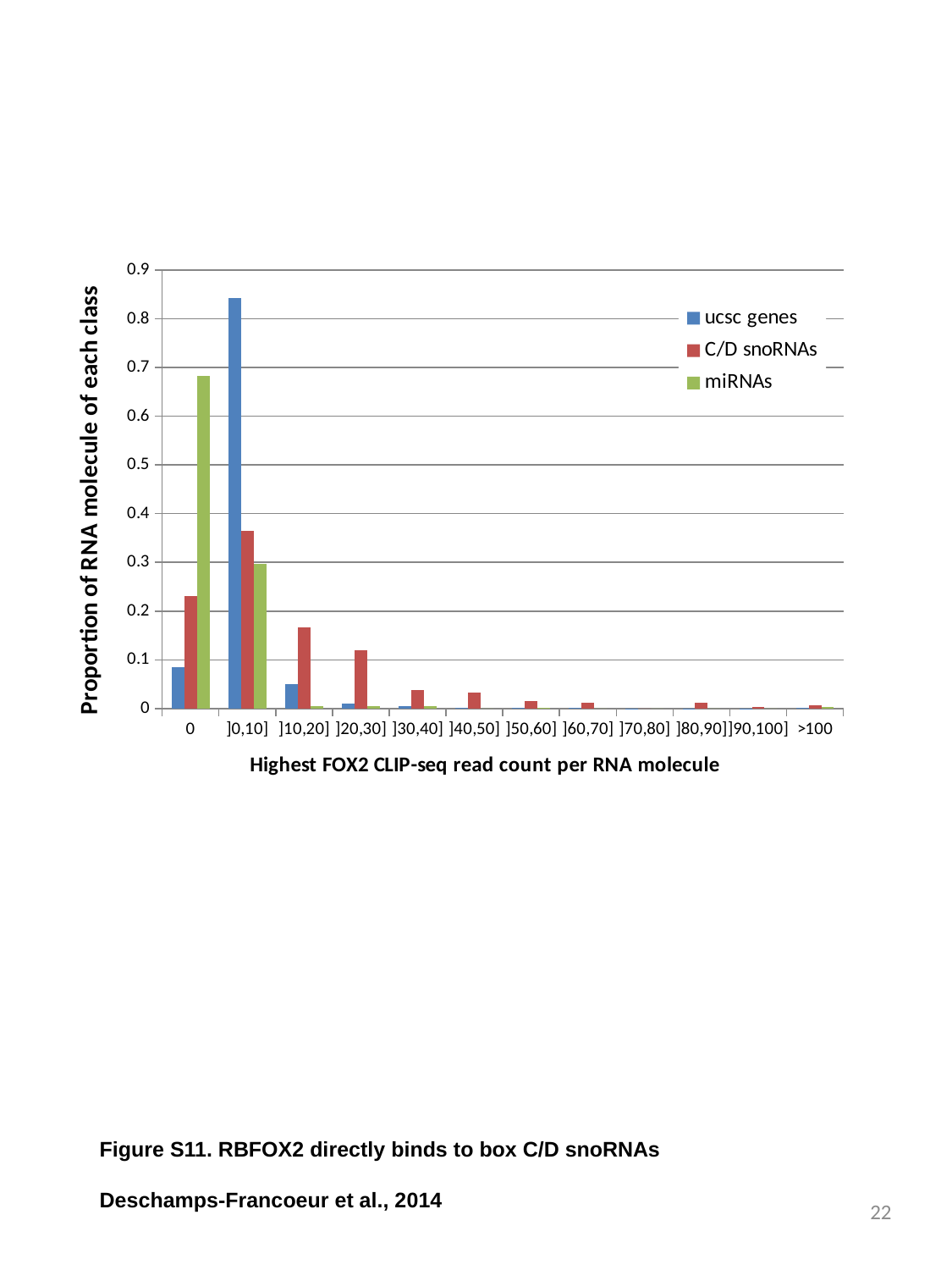
What is the title of the x axis? Highest FOX2 CLIP-seq read count per RNA molecule In the ]10,20] category, which is larger: the value for C/D snoRNAs or the value for ucsc genes? C/D snoRNAs Is the value for miRNAs in the 0 category greater or less than 0.6? greater What kind of chart is shown on the slide? bar chart How many categories are shown along the x axis? 12 How many series does the legend list? 3 Is the value for ucsc genes in the ]0,10] category greater or less than 0.8? greater Is the value for C/D snoRNAs in the ]0,10] category greater or less than 0.4? less In which category does the miRNAs series reach its highest value? 0 In which category does the ucsc genes series reach its highest value? ]0,10] In the 0 category, which is larger: the value for miRNAs or the value for ucsc genes? miRNAs